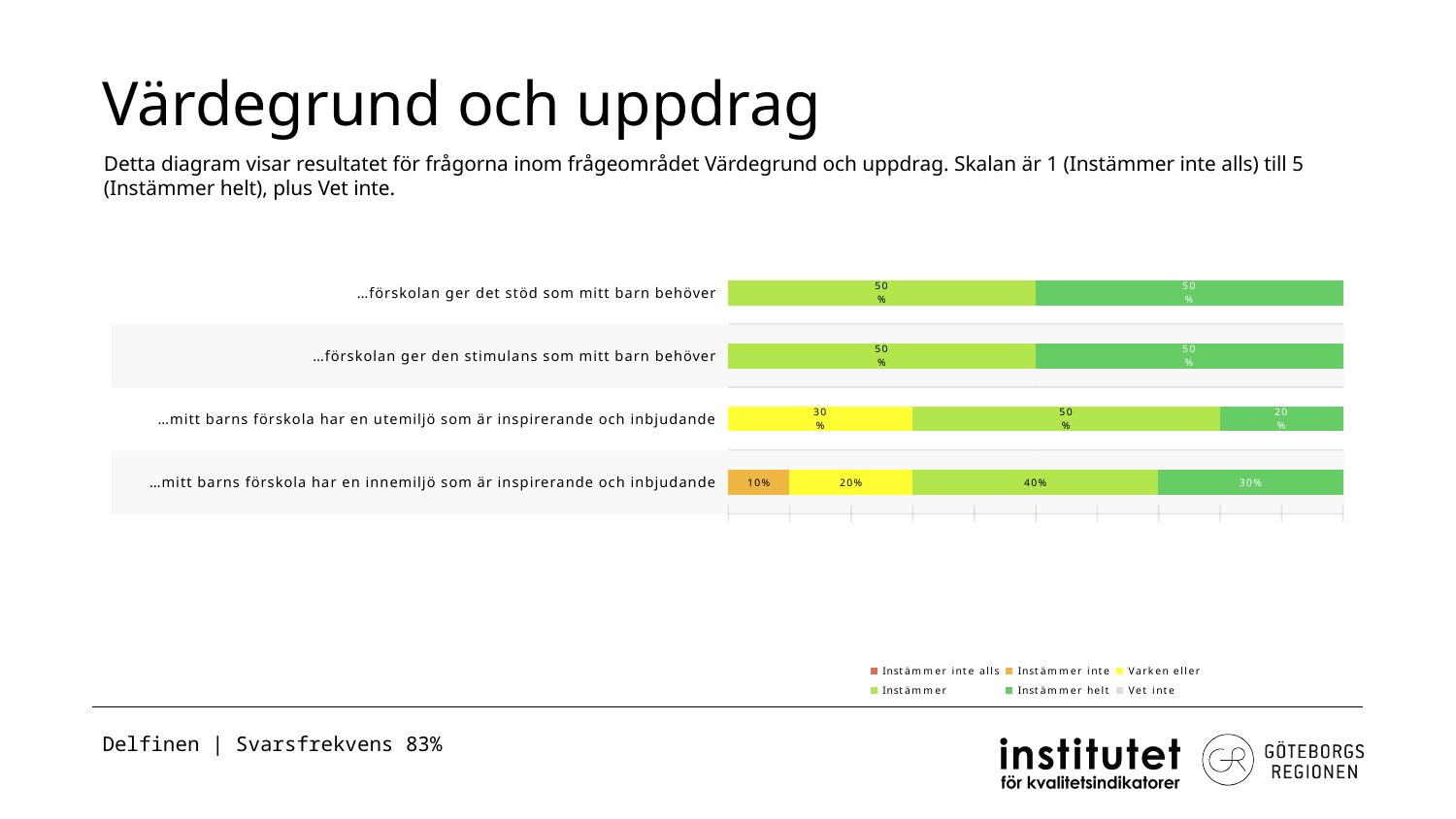
What is the 'Instämmer inte' share for '…mitt barns förskola har en innemiljö som är inspirerande och inbjudande'? 10% How many series does the legend list? 6 What is the difference between the 'Instämmer' share and the 'Instämmer helt' share for '…mitt barns förskola har en utemiljö som är inspirerande och inbjudande'? 30 percentage points Which category has the highest 'Instämmer helt' share? …förskolan ger det stöd som mitt barn behöver and …förskolan ger den stimulans som mitt barn behöver (50% each) What is the 'Instämmer helt' share for '…mitt barns förskola har en innemiljö som är inspirerande och inbjudande'? 30% Which category has the lowest 'Instämmer helt' share? …mitt barns förskola har en utemiljö som är inspirerande och inbjudande What is the 'Instämmer' share for '…förskolan ger det stöd som mitt barn behöver'? 50% What kind of chart is shown on the slide? stacked bar chart How many categories (questions) are plotted in the chart? 4 For '…mitt barns förskola har en innemiljö som är inspirerande och inbjudande', which is larger: the 'Instämmer' share or the 'Instämmer helt' share? Instämmer What is the combined share of 'Instämmer' and 'Instämmer helt' for '…mitt barns förskola har en innemiljö som är inspirerande och inbjudande'? 70% What is the 'Varken eller' share for '…mitt barns förskola har en utemiljö som är inspirerande och inbjudande'? 30%